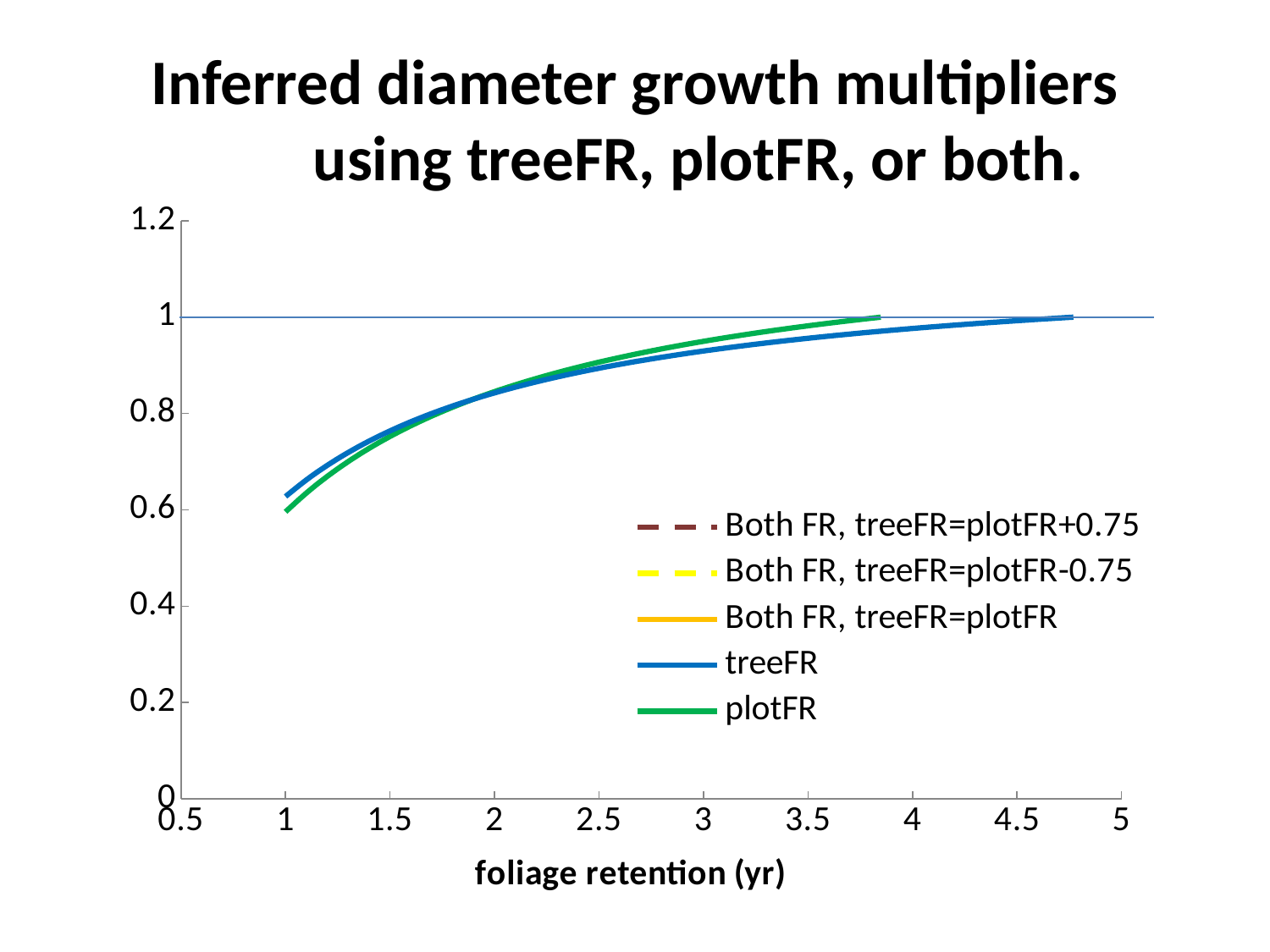
Is the value of the treeFR curve at a foliage retention of 4 yr greater or less than 0.8? greater What kind of chart is shown on the slide? line chart Is the value of the treeFR curve at a foliage retention of 1 yr greater or less than 1? less How many series does the legend list? 5 At a foliage retention of 1 yr, which curve has the higher value, treeFR or plotFR? treeFR Is the value of the plotFR curve at a foliage retention of 1 yr greater or less than 0.8? less Which curve extends to a larger foliage retention value on the x axis, treeFR or plotFR? treeFR What is the title of the chart? Inferred diameter growth multipliers using treeFR, plotFR, or both. Do the treeFR and plotFR curves rise or fall as foliage retention increases? rise At a foliage retention of 3 yr, which curve has the higher value, treeFR or plotFR? plotFR What is the label of the x axis? foliage retention (yr)